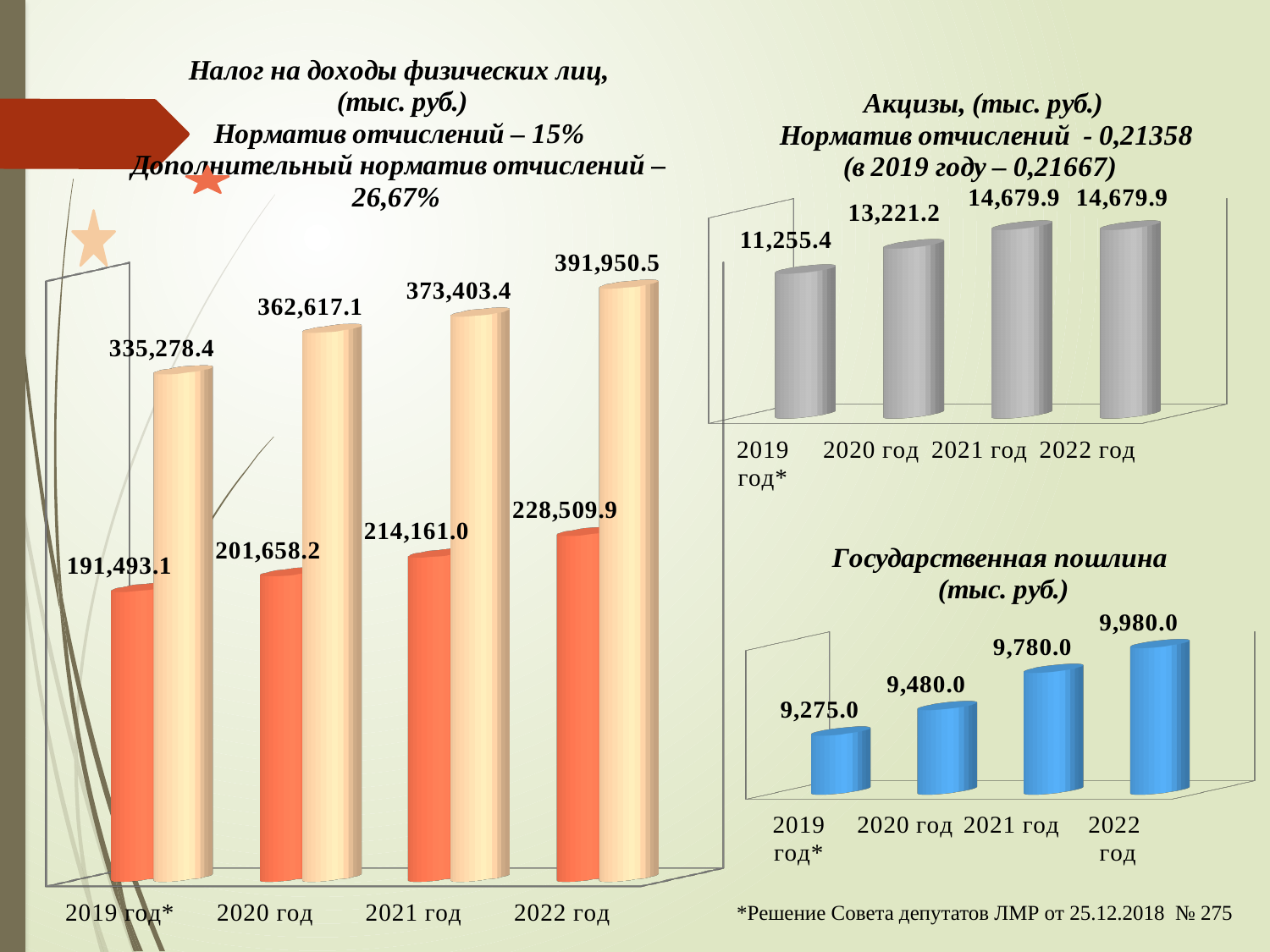
On the 'Налог на доходы физических лиц' chart, which year has the highest beige bar? 2022 год On the 'Акцизы' chart, do the values rise or fall from 2019 год* to 2021 год? rise On the 'Акцизы' chart, what is the value for 2019 год*? 11,255.4 What kind of chart is the 'Государственная пошлина' chart? bar chart On the 'Акцизы' chart, how many years are shown? 4 On the 'Государственная пошлина' chart, what is the value for 2022 год? 9,980.0 On the 'Налог на доходы физических лиц' chart, what is the value of the beige bar for 2022 год? 391,950.5 On the 'Акцизы' chart, what is the value for 2020 год? 13,221.2 On the 'Налог на доходы физических лиц' chart, what is the value of the orange bar for 2021 год? 214,161.0 On the 'Государственная пошлина' chart, what is the difference between the 2022 год and 2019 год* values? 705.0 On the 'Налог на доходы физических лиц' chart, what is the difference between the beige and orange bars for 2019 год*? 143,785.3 On the 'Государственная пошлина' chart, which year has the lowest value? 2019 год*